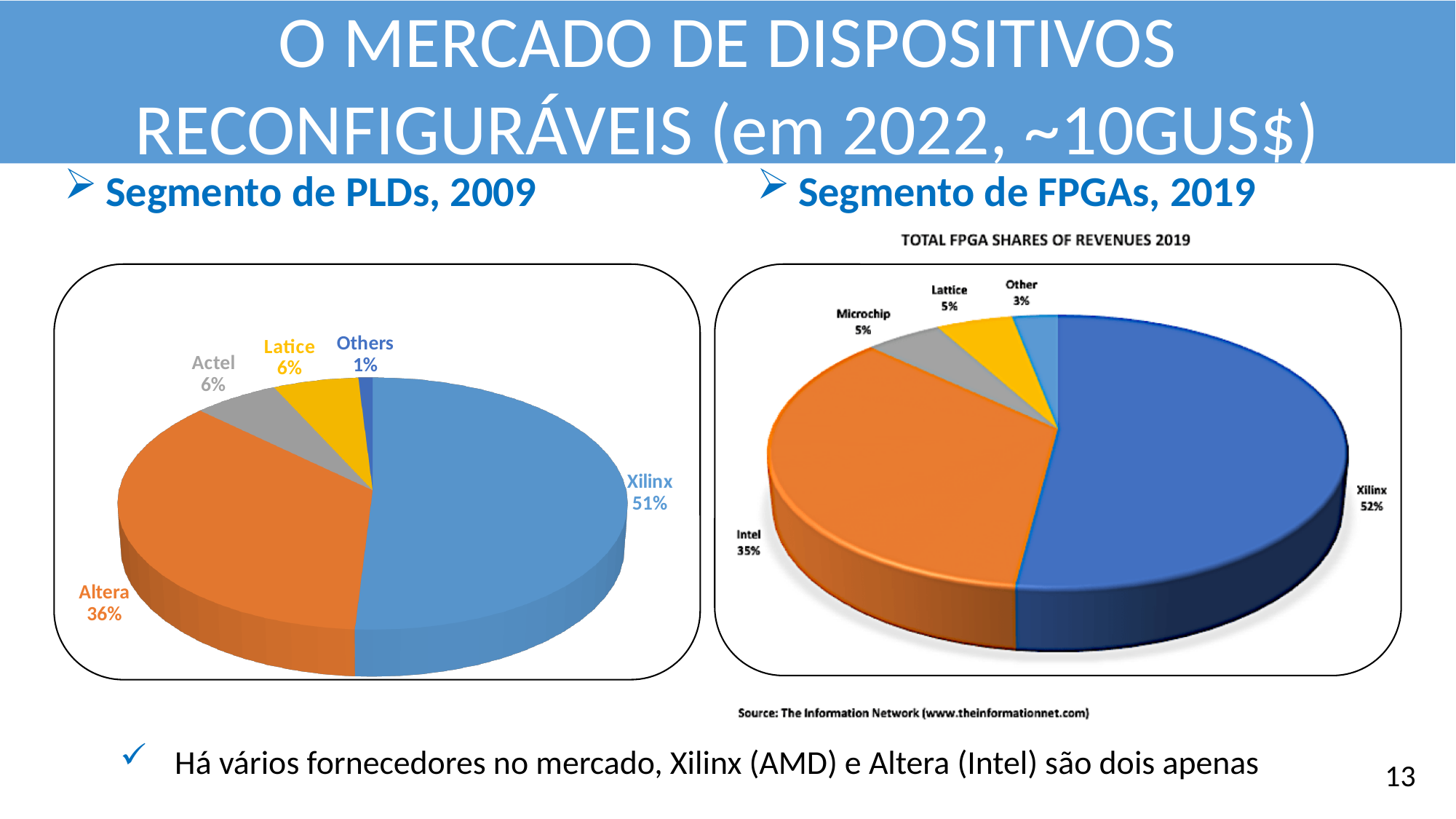
What is the title of the chart on the right side of the slide? TOTAL FPGA SHARES OF REVENUES 2019 In the left pie chart (Segmento de PLDs, 2009), which company has the largest share? Xilinx In the right chart (TOTAL FPGA SHARES OF REVENUES 2019), what share does Microchip hold? 5% In the right chart (TOTAL FPGA SHARES OF REVENUES 2019), what is the difference between the Xilinx and Intel shares? 17% In the left pie chart (Segmento de PLDs, 2009), which category has the smallest share? Others In the left pie chart (Segmento de PLDs, 2009), what share does Altera hold? 36% In the left pie chart (Segmento de PLDs, 2009), how many slices does the pie have? 5 In the left pie chart (Segmento de PLDs, 2009), what share does Xilinx hold? 51% In the right chart (TOTAL FPGA SHARES OF REVENUES 2019), what share does Intel hold? 35% What type of chart is used on the right side of the slide (TOTAL FPGA SHARES OF REVENUES 2019)? Pie chart In the right chart (TOTAL FPGA SHARES OF REVENUES 2019), which company has the largest share? Xilinx In the left pie chart (Segmento de PLDs, 2009), what is the difference between the Xilinx and Altera shares? 15%